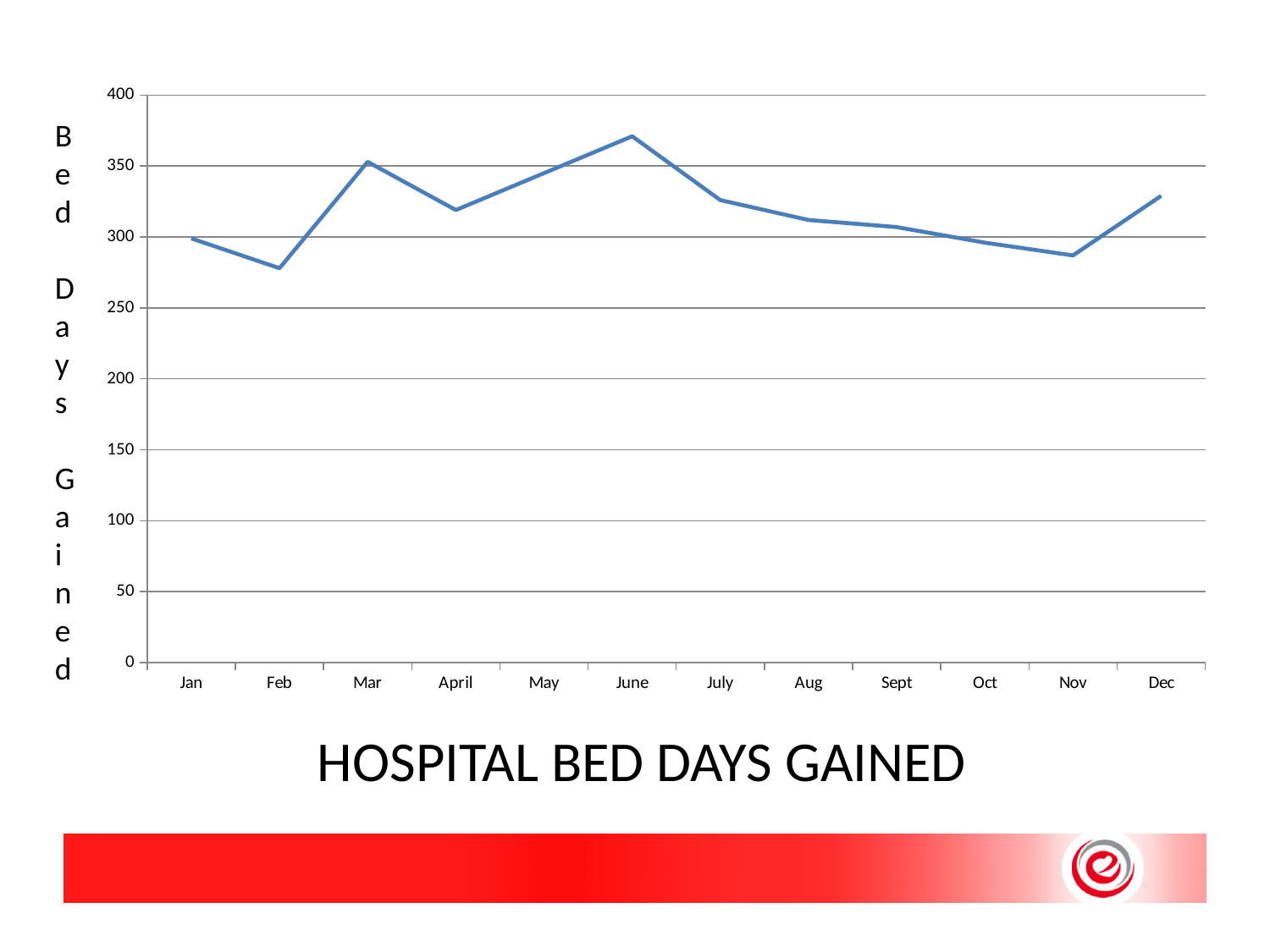
Is the value for June greater or less than 350? greater What is the title of the chart? HOSPITAL BED DAYS GAINED Do the values rise or fall from June to Nov? fall Which is larger, the value for Mar or the value for April? Mar What is the label on the vertical axis? Bed Days Gained How many months are plotted along the x axis? 12 Is the value for Feb greater or less than 300? less Is the value for April greater or less than 300? greater Which month has the highest value? June Which is larger, the value for Nov or the value for Dec? Dec What kind of chart is shown on the slide? line chart